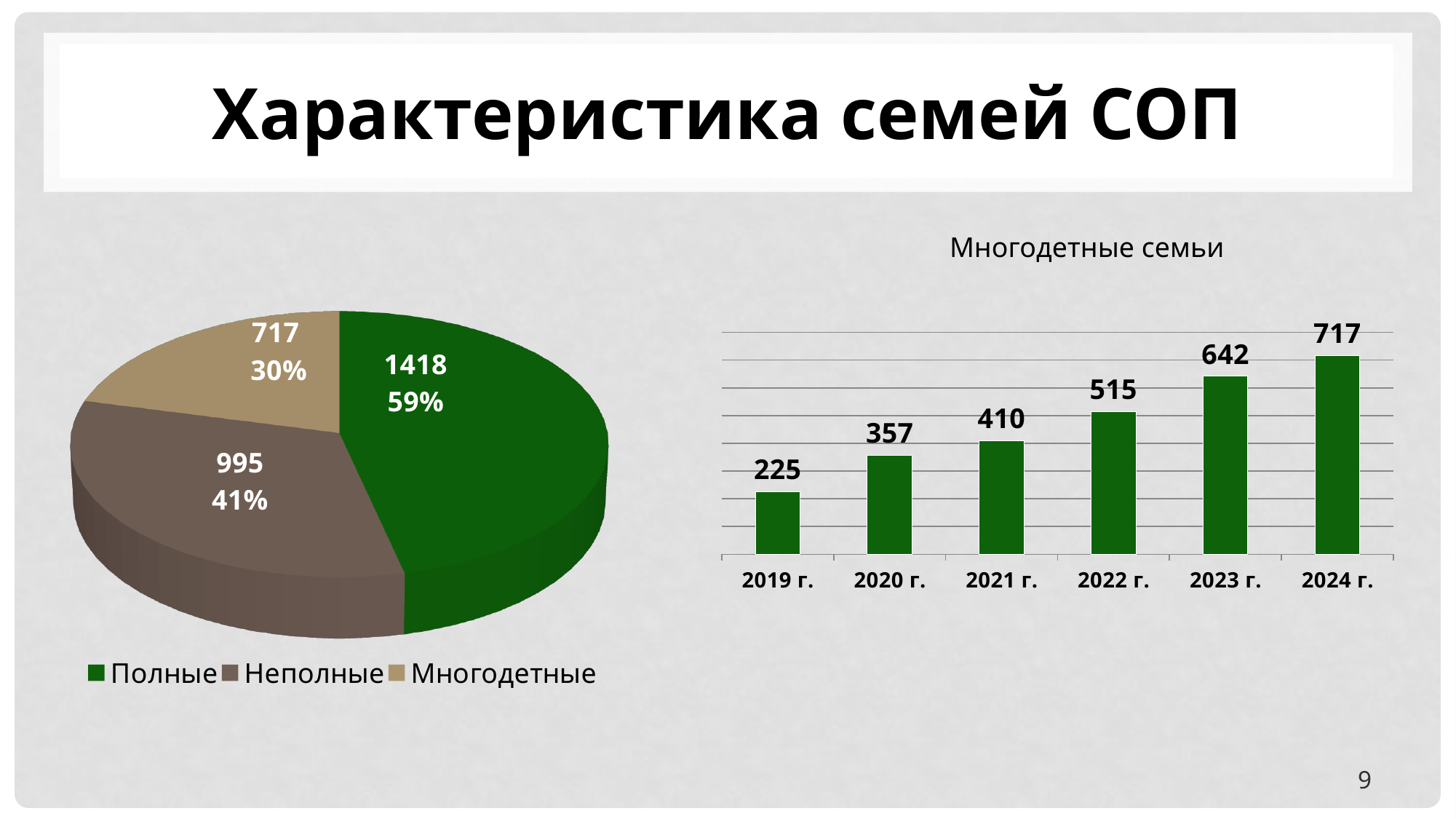
What kind of chart is the one titled Многодетные семьи? bar chart In the chart titled Многодетные семьи, how many years are shown on the x axis? 6 In the chart titled Многодетные семьи, what is the value for 2021 г.? 410 In the chart titled Многодетные семьи, what is the difference between the values for 2024 г. and 2019 г.? 492 In the pie chart on the left, what is the difference between the values for Полные and Неполные? 423 In the pie chart on the left, what percentage is shown for the Многодетные slice? 30% In the chart titled Многодетные семьи, which year has the lowest value? 2019 г. In the chart titled Многодетные семьи, do the values rise or fall from 2019 г. to 2024 г.? rise In the pie chart on the left, what value is shown for the Полные slice? 1418 In the pie chart on the left, how many categories does the legend list? 3 In the pie chart on the left, what percentage is shown for the Неполные slice? 41% In the pie chart on the left, which category has the largest slice? Полные